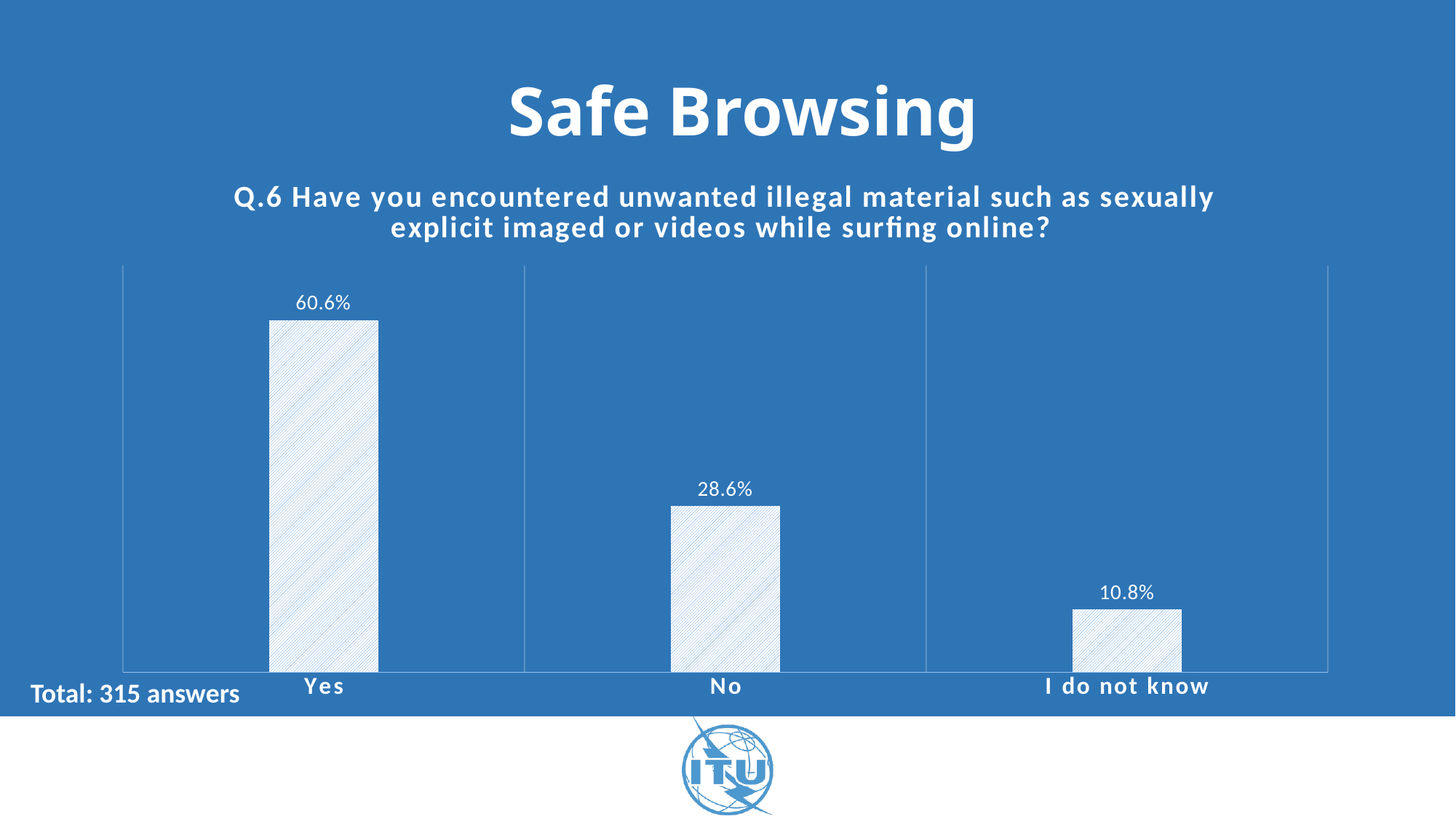
Which is larger, the percentage for "No" or for "I do not know"? No What percentage of respondents answered "I do not know"? 10.8% Do the values rise or fall moving from left to right across the categories? Fall What percentage of respondents answered "Yes"? 60.6% What is the difference in percentage points between the "Yes" and "No" responses? 32.0% Which answer category has the lowest percentage? I do not know What type of chart is shown on the slide? Bar chart Which answer category has the highest percentage? Yes How many total answers does the slide say the chart is based on? 315 answers What percentage of respondents answered "No"? 28.6% How many answer categories are shown in the chart? 3 What is the difference in percentage points between the "No" and "I do not know" responses? 17.8%